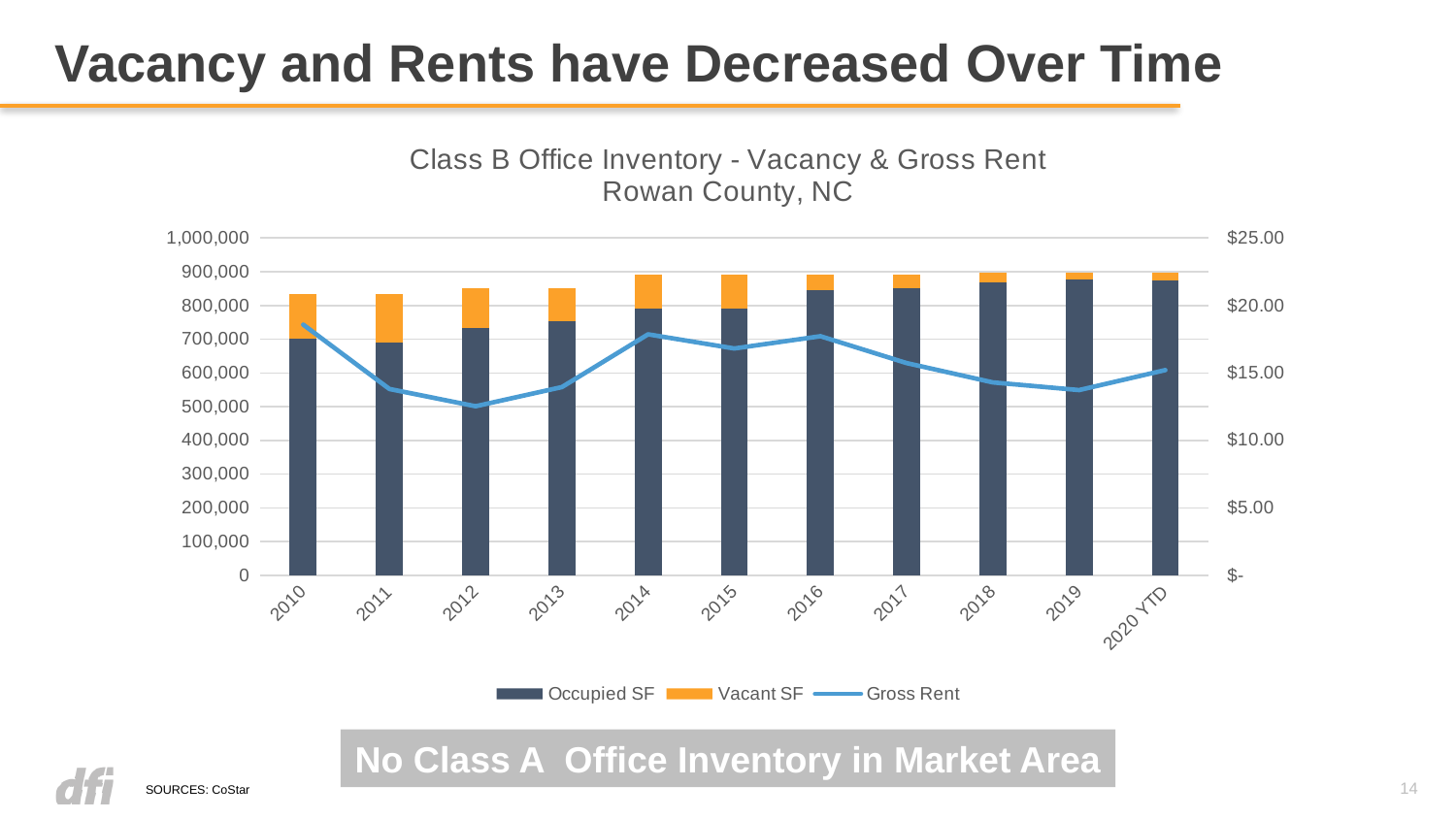
Is the Gross Rent for 2019 greater or less than $15.00? less Is the Occupied SF for 2018 greater or less than 800,000? greater What is the title of the chart? Class B Office Inventory - Vacancy & Gross Rent Rowan County, NC Which year has the highest Gross Rent? 2010 Does Occupied SF generally rise or fall from 2010 to 2020 YTD? rise How many series does the legend list? 3 Is the Occupied SF for 2010 greater or less than 800,000? less How many years (categories) are shown on the x axis? 11 What kind of chart is shown on the slide? A combination chart with stacked bars and a line Which year has the larger Occupied SF, 2010 or 2019? 2019 Which year has the lowest Gross Rent? 2012